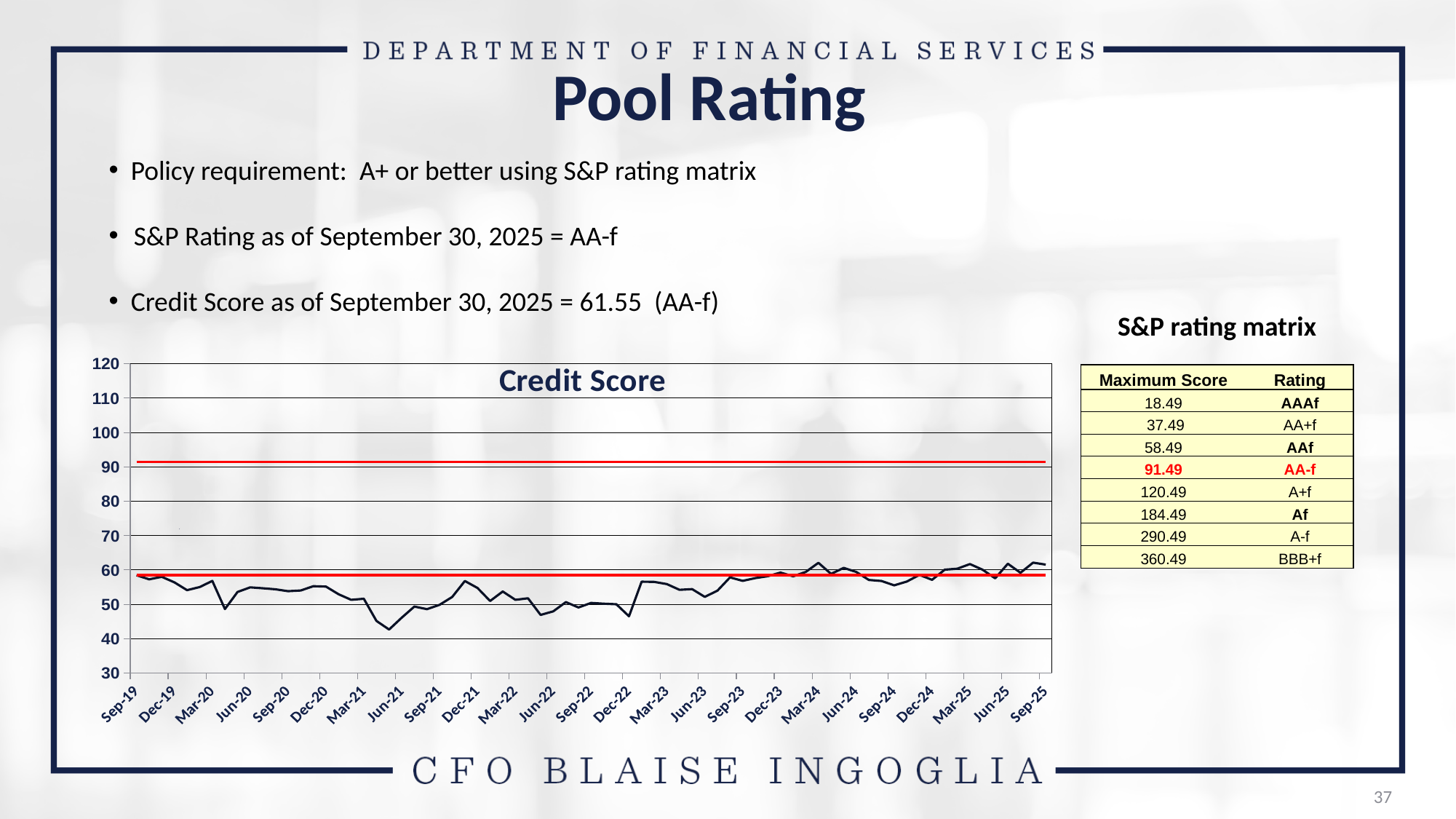
Is the credit score at Mar-24 greater or less than 60? greater What kind of chart is the Credit Score chart? line chart What is the credit score as of September 30, 2025, as stated on the slide? 61.55 What is the title of the chart on the slide? Credit Score What is the highest value shown on the y-axis of the Credit Score chart? 120 Is the credit score at Sep-25 greater or less than 60? greater Is the credit score at Dec-22 greater or less than 50? less Does the credit score generally rise or fall between Jun-21 and Mar-24? rise Which is larger, the credit score at Jun-21 or at Mar-24? Mar-24 How many date labels are shown along the x-axis of the Credit Score chart? 25